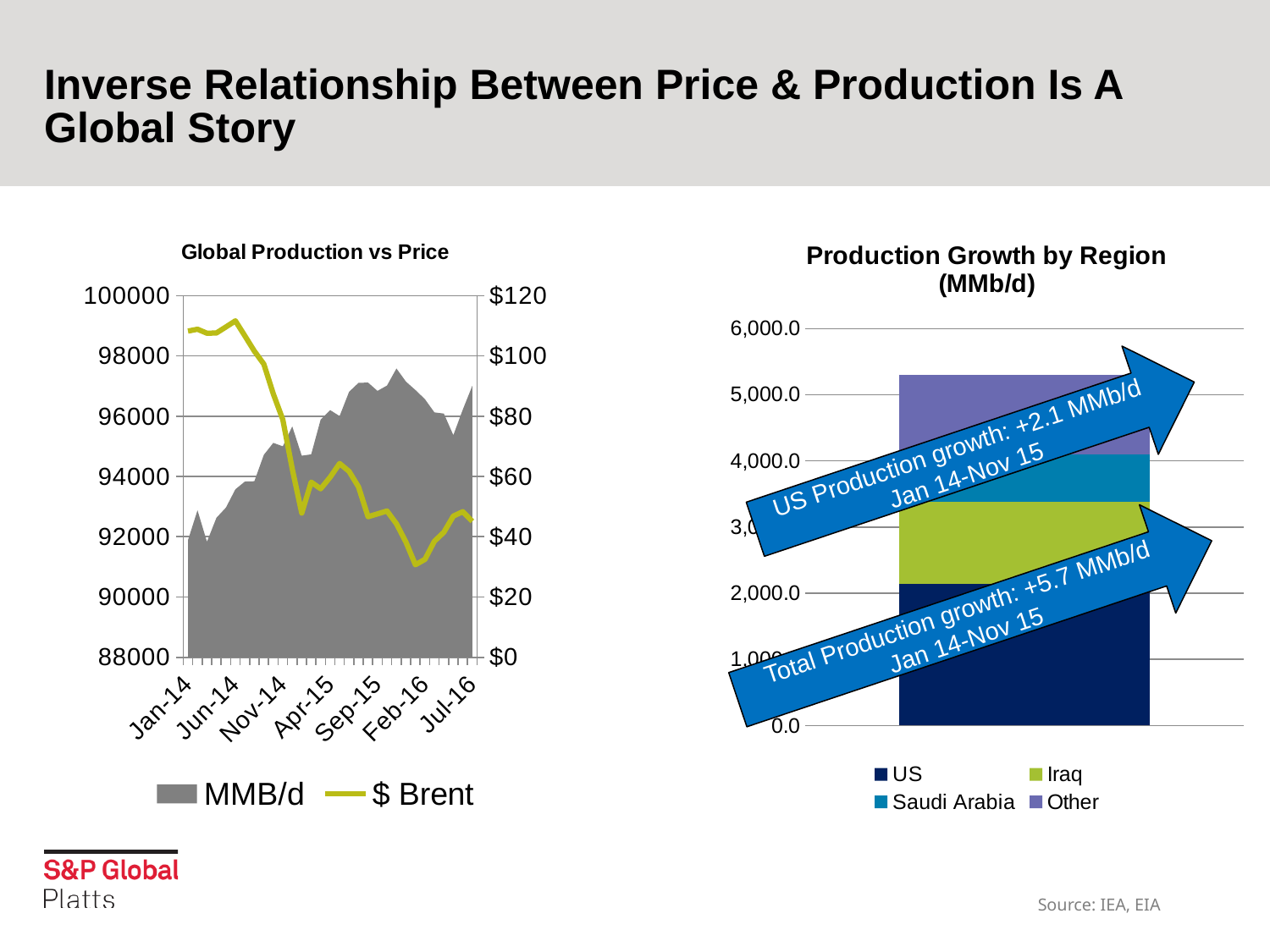
In the 'Global Production vs Price' chart, is the $ Brent value around Feb-16 greater or less than $40? less How many series does the legend of the 'Production Growth by Region (MMb/d)' chart list? 4 How many series does the legend of the 'Global Production vs Price' chart list? 2 What kind of chart is the 'Global Production vs Price' chart on the left? An area chart with a line overlay According to the annotation on the 'Production Growth by Region (MMb/d)' chart, what was US production growth from Jan 14 to Nov 15? +2.1 MMb/d According to the annotation on the 'Production Growth by Region (MMb/d)' chart, what was total production growth from Jan 14 to Nov 15? +5.7 MMb/d In the 'Global Production vs Price' chart, is the $ Brent value at Jan-14 greater or less than $100? greater In the 'Global Production vs Price' chart, is the MMB/d production value at Jan-14 greater or less than 94000? less What kind of chart is the 'Production Growth by Region (MMb/d)' chart on the right? A stacked bar chart What are the two legend entries of the 'Global Production vs Price' chart? MMB/d and $ Brent In the 'Production Growth by Region (MMb/d)' chart, which region has the largest segment of the stacked bar? US In the 'Global Production vs Price' chart, does the $ Brent line overall rise or fall from Jan-14 to Jul-16? Fall